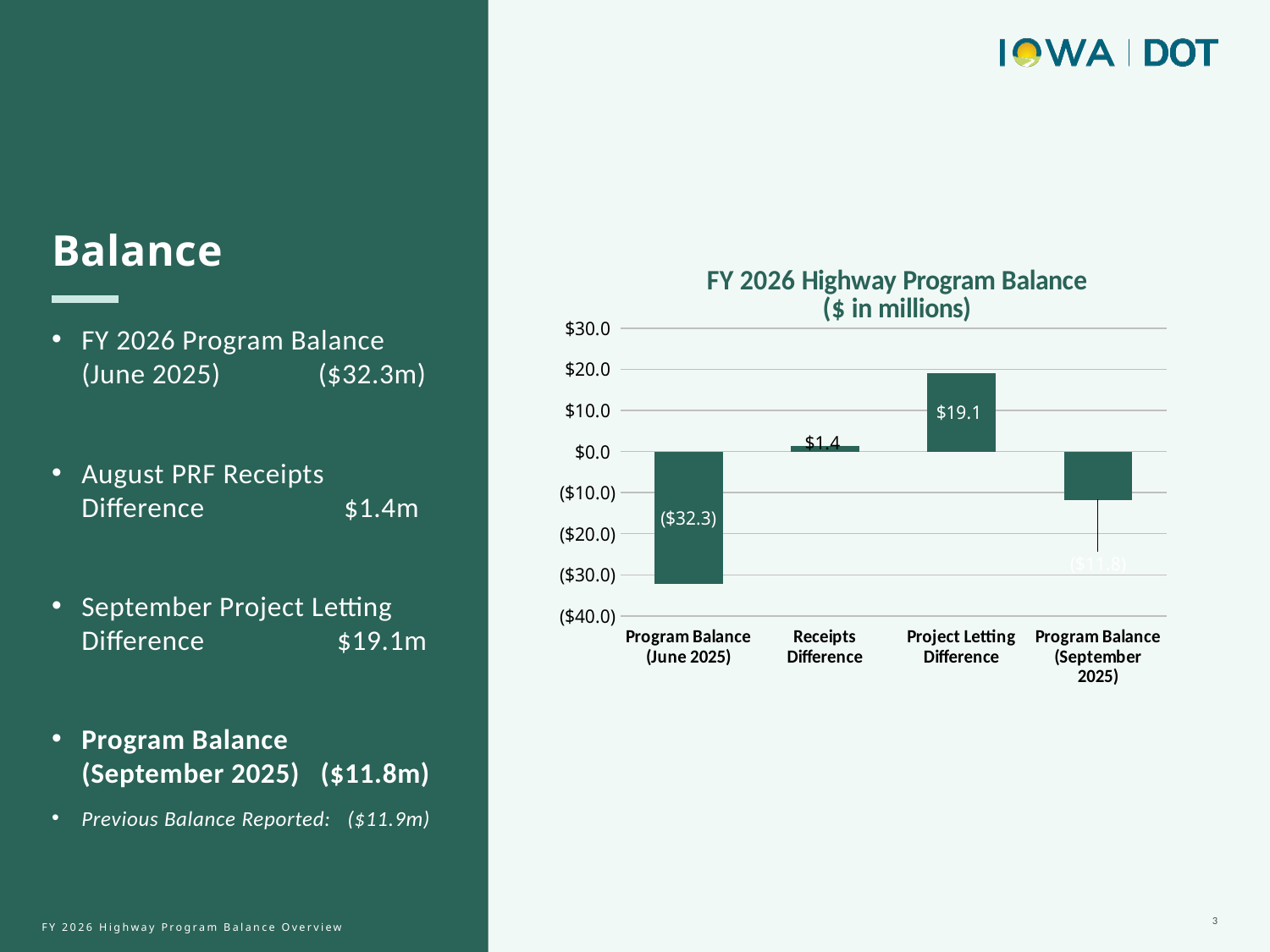
What is the value for Project Letting Difference in the chart? $19.1 Is the value for Project Letting Difference greater or less than $10.0? greater What is the difference between the Project Letting Difference and the Receipts Difference values? $17.7 What is the value for Receipts Difference in the chart? $1.4 What kind of chart is shown on the slide? bar chart What is the value for Program Balance (September 2025) in the chart? ($11.8) How many categories are shown on the x axis of the chart? 4 Which category has the highest value in the chart? Project Letting Difference What is the value for Program Balance (June 2025) in the chart? ($32.3) Which is larger, the Receipts Difference or the Project Letting Difference? Project Letting Difference What is the title of the chart? FY 2026 Highway Program Balance ($ in millions) Which category has the lowest value in the chart? Program Balance (June 2025)